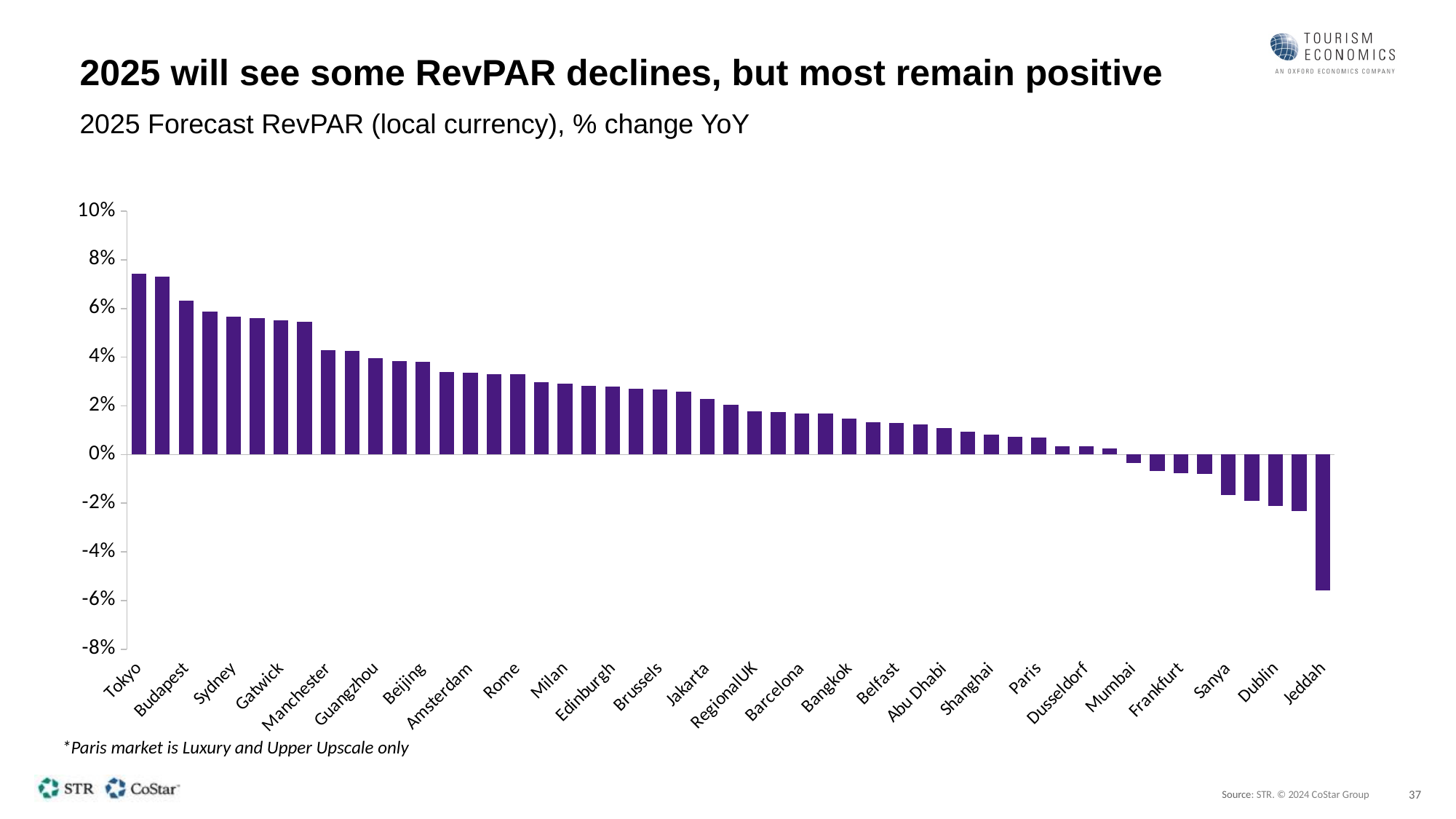
Which market has the lowest 2025 forecast RevPAR change? Jeddah Is the value for Tokyo greater or less than 6%? greater What is the subtitle describing the chart's measure? 2025 Forecast RevPAR (local currency), % change YoY Which has the larger forecast RevPAR change, Sanya or Manchester? Manchester Which market has the highest 2025 forecast RevPAR change? Tokyo Is the value for Jeddah greater or less than -4%? less Which has the larger forecast RevPAR change, Sydney or Rome? Sydney Is the value for Sydney greater or less than 4%? greater Do the values rise or fall moving from left to right along the x axis? fall What kind of chart is shown on the slide? bar chart